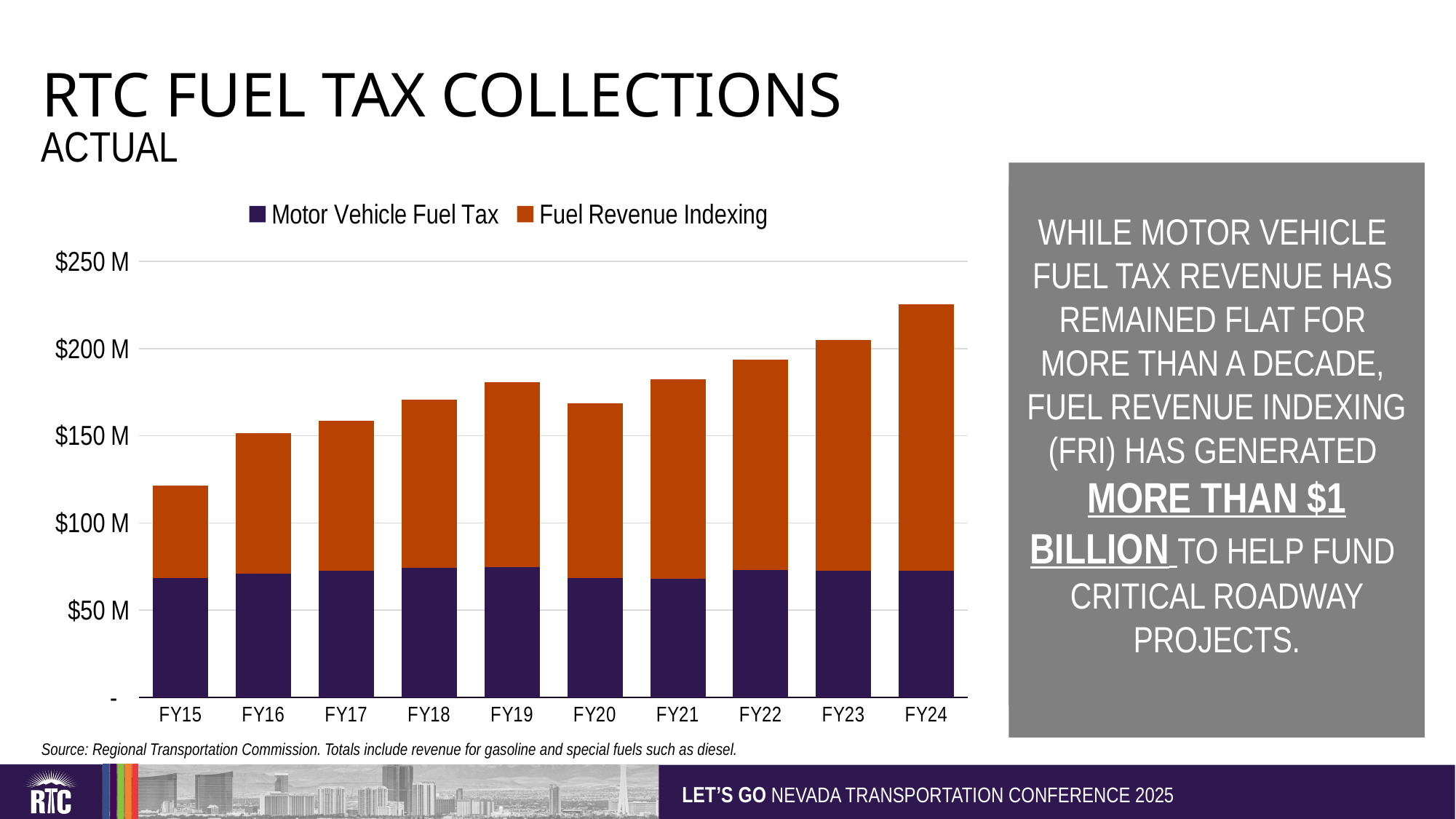
Is the total bar for FY24 greater or less than $200 M? greater Do total fuel tax collections generally rise or fall from FY15 to FY24? Rise Which fiscal year has the highest total fuel tax collections? FY24 Which series is shown in orange in the chart legend? Fuel Revenue Indexing Is the total bar for FY20 greater or less than $200 M? less What kind of chart is shown on the slide? Stacked bar chart Is the Motor Vehicle Fuel Tax value for FY15 greater or less than $100 M? less How many fiscal years are shown on the x axis of the chart? 10 Which has the larger total collections, FY19 or FY20? FY19 How many series does the chart legend list? 2 Which fiscal year has the lowest total fuel tax collections? FY15